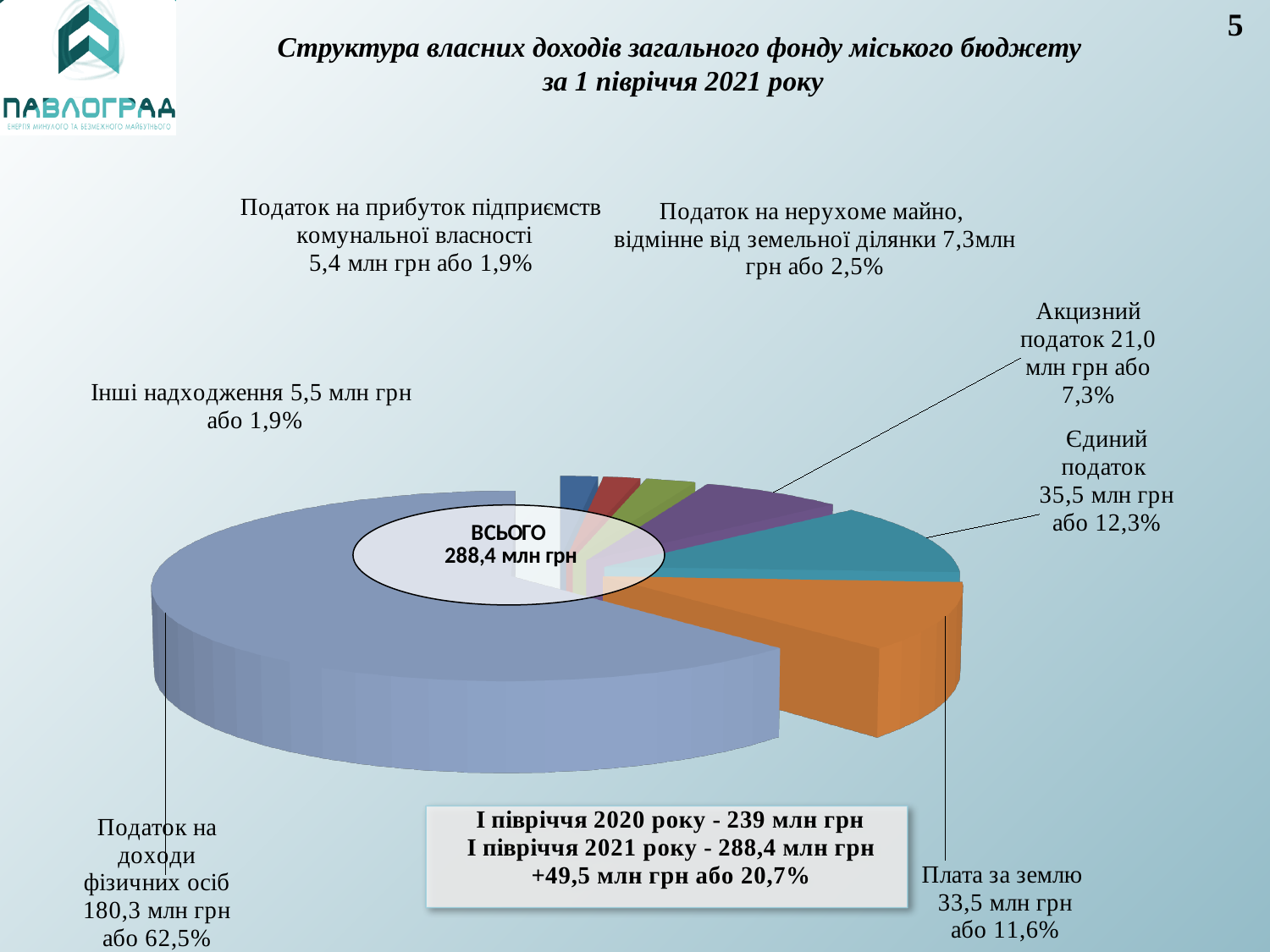
What share of the pie does Плата за землю represent? 11,6% What share of the pie does Інші надходження represent? 1,9% What share of the pie does Єдиний податок represent? 12,3% Which is larger: Акцизний податок or Податок на нерухоме майно, відмінне від земельної ділянки? Акцизний податок What is the value for Податок на доходи фізичних осіб? 180,3 млн грн What is the difference in млн грн between Єдиний податок and Плата за землю? 2,0 млн грн How many categories are shown in the pie chart? 7 Which category has the smallest value in млн грн? Податок на прибуток підприємств комунальної власності What total value is shown in the centre of the pie chart (ВСЬОГО)? 288,4 млн грн What is the value for Акцизний податок? 21,0 млн грн What kind of chart is shown on the slide? Pie chart Which category has the largest slice of the pie? Податок на доходи фізичних осіб